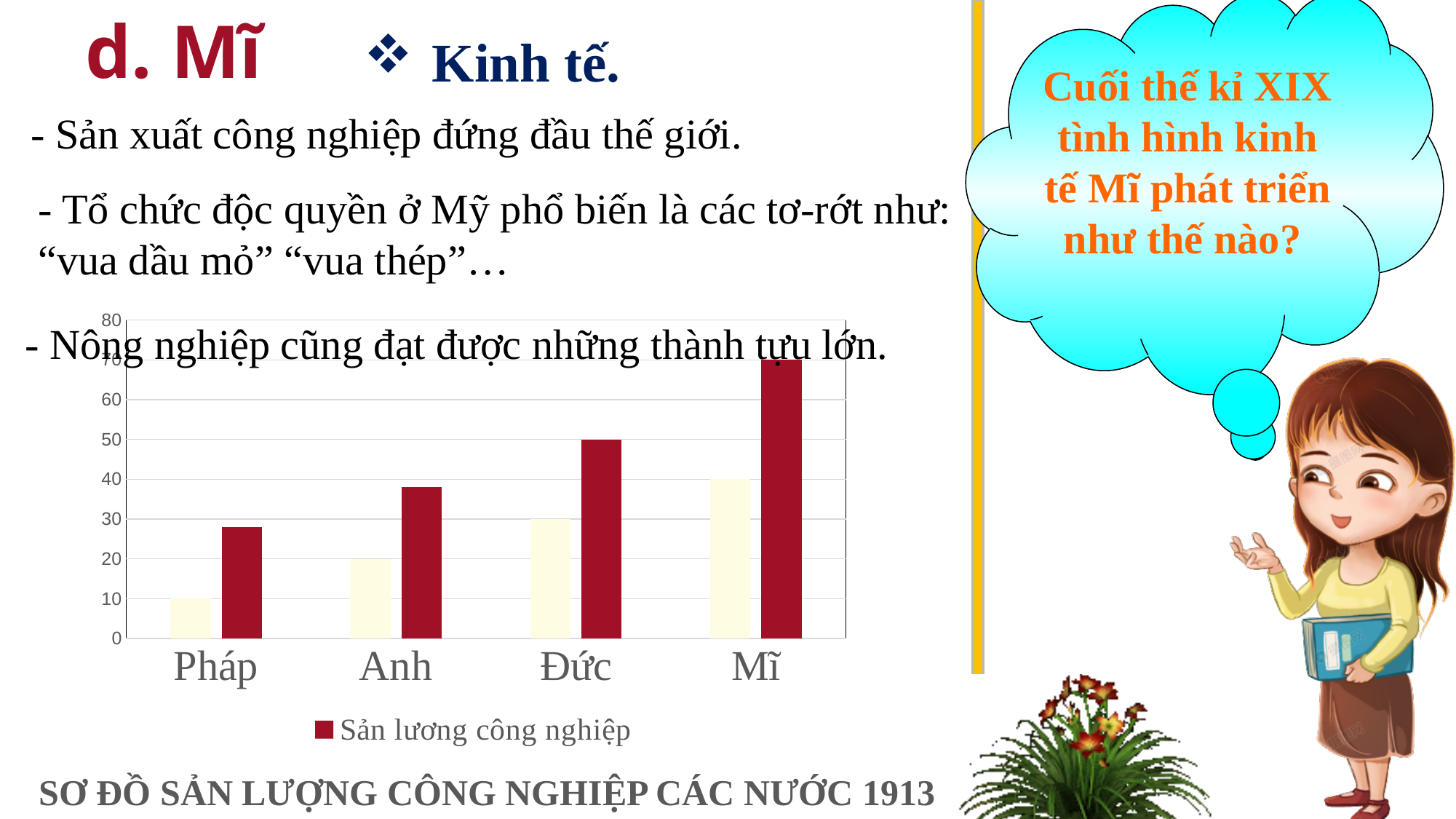
What is the value of Sản lượng công nghiệp for Mĩ? 70 Is the value of Sản lượng công nghiệp for Anh greater or less than 40? less What is the value of Sản lượng công nghiệp for Đức? 50 What is the difference between the Sản lượng công nghiệp values for Mĩ and Đức? 20 What kind of chart is shown on the slide? bar chart How many countries are shown on the x axis of the chart? 4 Which country has the highest value for Sản lượng công nghiệp? Mĩ How many series does the chart's legend list? 1 Is the value of Sản lượng công nghiệp for Pháp greater or less than 30? less Which has a larger value for Sản lượng công nghiệp, Đức or Anh? Đức Do the Sản lượng công nghiệp values rise or fall from Pháp to Mĩ along the x axis? rise Which country has the lowest value for Sản lượng công nghiệp? Pháp